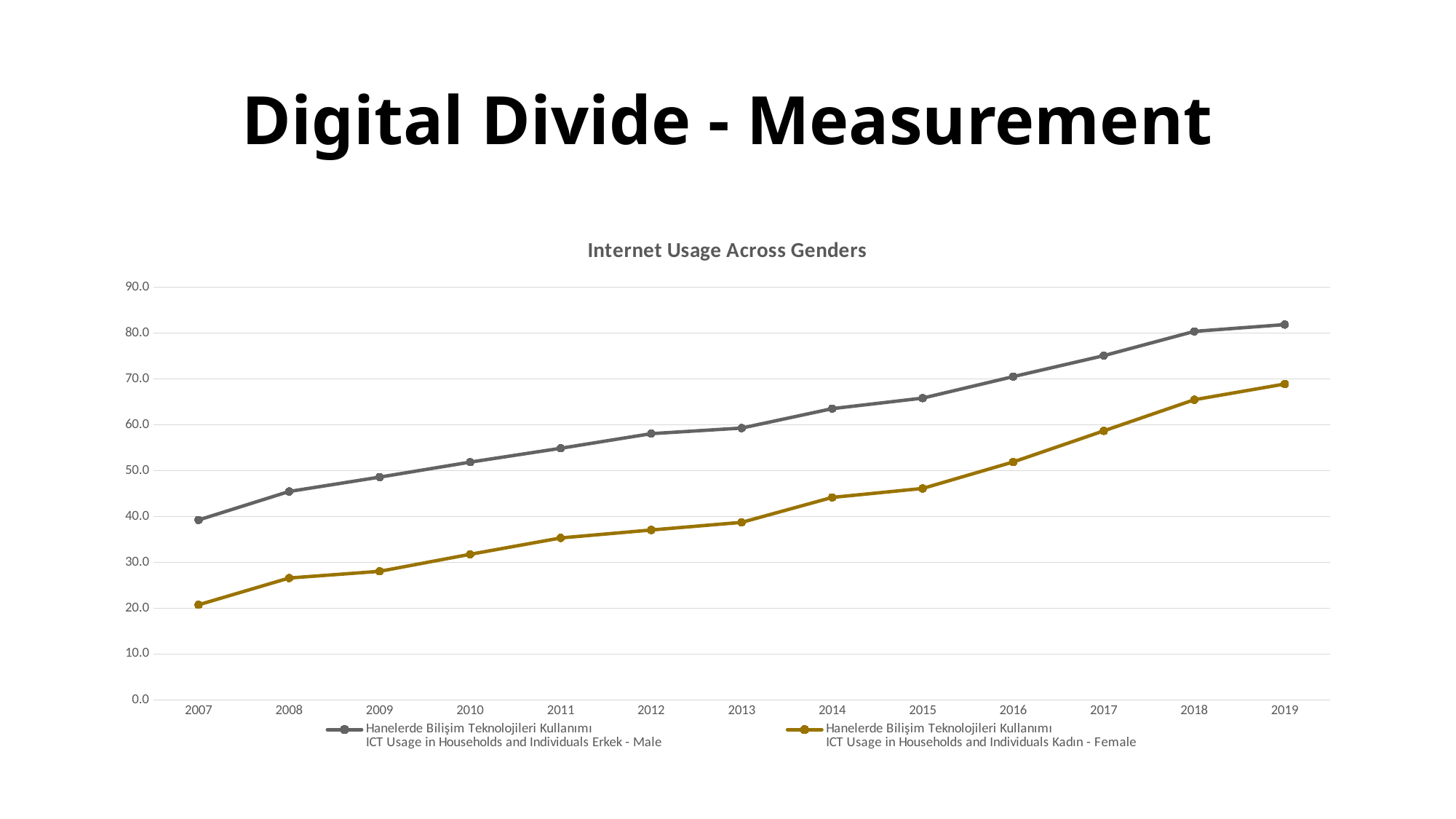
How many years are plotted along the x axis? 13 In 2012, which series has the larger value, Male or Female? Male Is the value for the Male series in 2010 greater or less than 50? greater In which year is the Male series at its highest? 2019 In which year is the Female series at its lowest? 2007 What type of chart is shown on the slide? line chart Do the values for the Female series rise or fall from 2007 to 2019? rise What is the title of the chart? Internet Usage Across Genders Is the value for the Female series in 2010 greater or less than 30? greater Is the value for the Male series in 2019 greater or less than 80? greater How many series does the legend list? 2